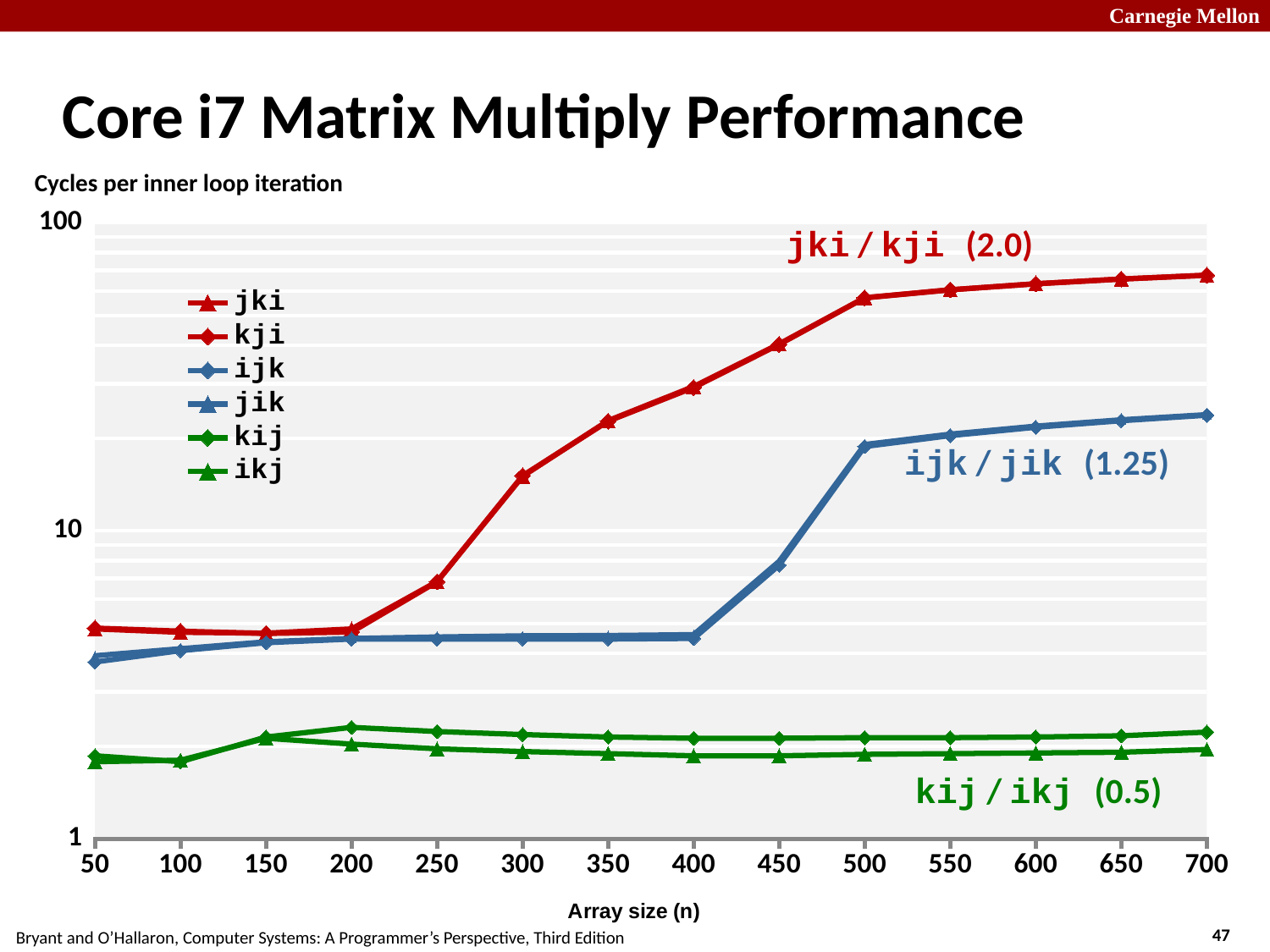
Is the value for jki at array size 700 greater or less than 10? greater Is the value for ijk at array size 400 greater or less than 10? less Does the jki series rise or fall as array size increases from 50 to 700? rise How many series does the legend list? 6 What kind of chart is shown on the slide? line chart What is the label of the x axis? Array size (n) Which is larger at array size 700, jki or kij? jki How many array-size values are plotted along the x axis? 14 Which is larger at array size 300, jki or ijk? jki What is the title of the chart? Core i7 Matrix Multiply Performance Is the value for jki at array size 50 greater or less than 10? less